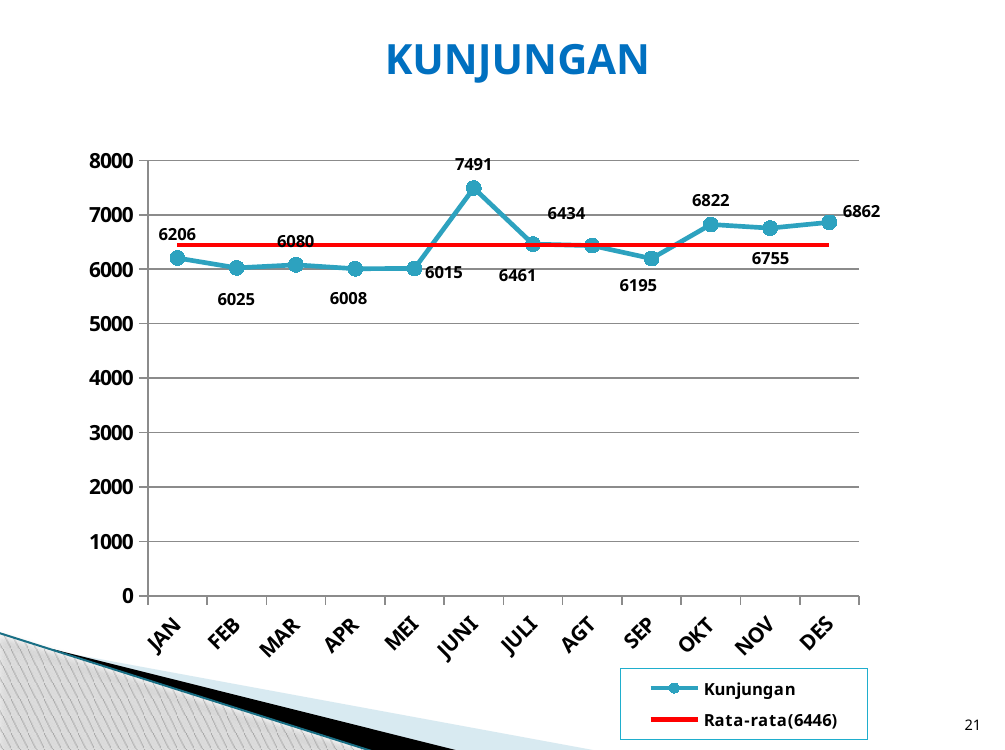
Is the Kunjungan value for SEP greater or less than 7000? less How many series does the legend list? 2 What is the Kunjungan value for OKT? 6822 Which month has the highest Kunjungan value? JUNI What is the Kunjungan value for JUNI? 7491 Which month has a larger Kunjungan value, OKT or NOV? OKT How many months are plotted on the x axis? 12 What kind of chart is shown on the slide? line chart What is the difference between the Kunjungan values for DES and JAN? 656 Does the Kunjungan value rise or fall from MEI to JUNI? rise Which month has the lowest Kunjungan value? APR What average value (Rata-rata) is shown in the legend? 6446